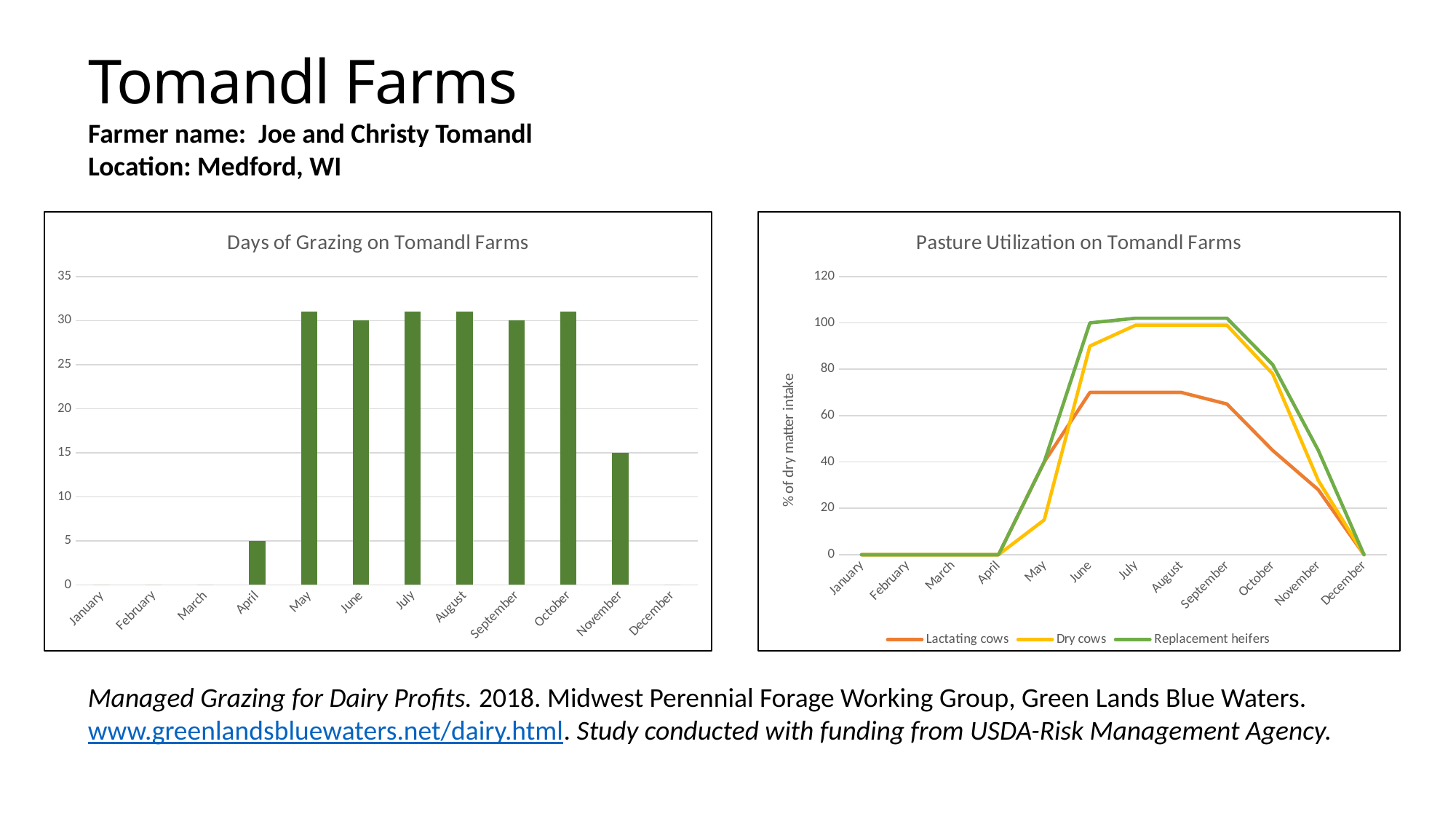
On the 'Days of Grazing on Tomandl Farms' chart, how many days of grazing are shown for June? 30 On the 'Days of Grazing on Tomandl Farms' chart, which has more days of grazing, April or November? November On the 'Days of Grazing on Tomandl Farms' chart, is the value for May greater or less than 25? greater On the 'Days of Grazing on Tomandl Farms' chart, how many months are shown on the x axis? 12 On the 'Pasture Utilization on Tomandl Farms' chart, which series has the higher value in June, Lactating cows or Replacement heifers? Replacement heifers On the 'Days of Grazing on Tomandl Farms' chart, how many days of grazing are shown for November? 15 On the 'Pasture Utilization on Tomandl Farms' chart, how many series does the legend list? 3 On the 'Days of Grazing on Tomandl Farms' chart, what kind of chart is shown? bar chart On the 'Pasture Utilization on Tomandl Farms' chart, is the value for Dry cows in May greater or less than 20? less On the 'Pasture Utilization on Tomandl Farms' chart, what kind of chart is shown? line chart On the 'Days of Grazing on Tomandl Farms' chart, how many days of grazing are shown for April? 5 On the 'Pasture Utilization on Tomandl Farms' chart, what is the value for Lactating cows in January? 0